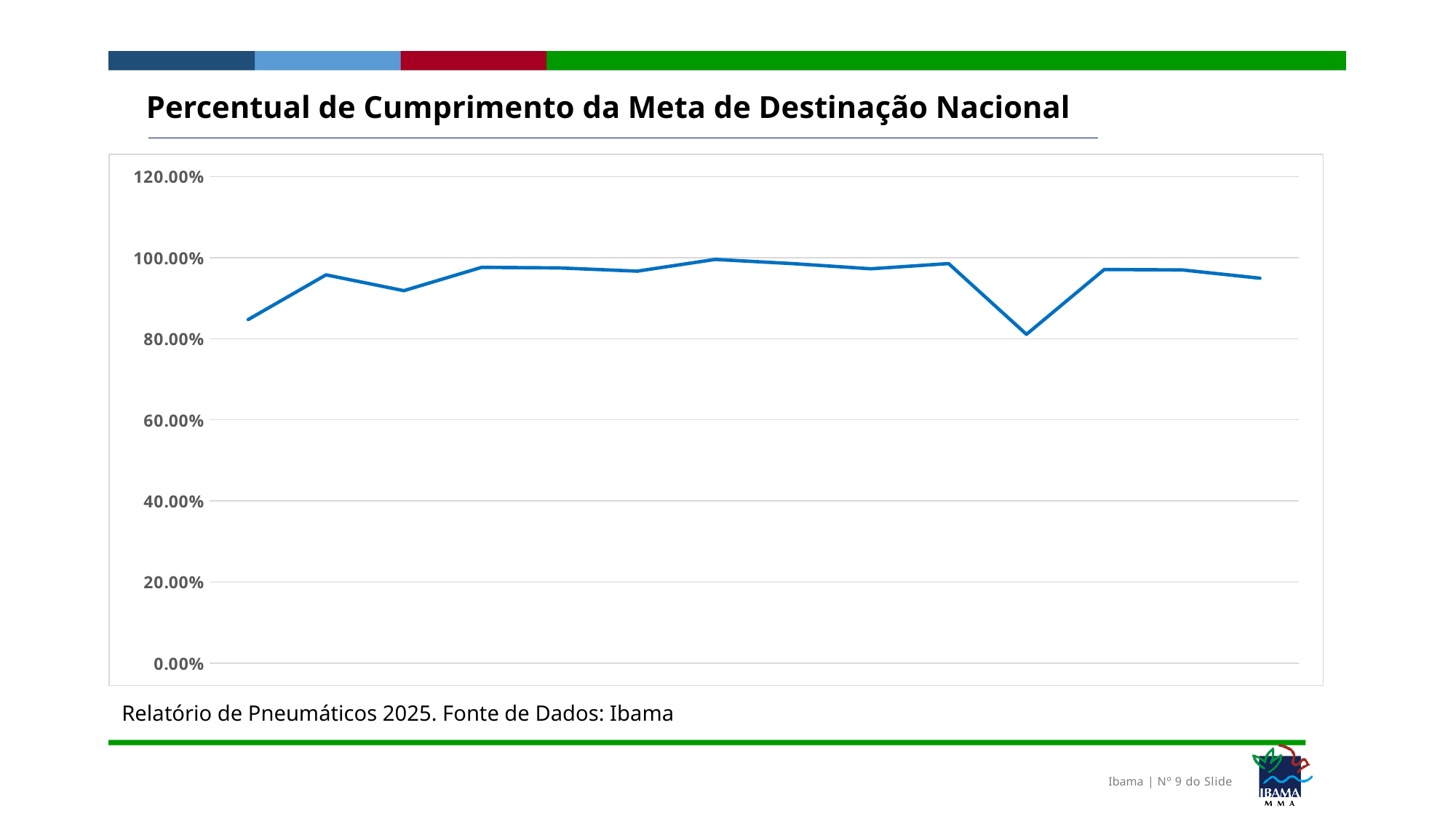
What kind of chart is shown on the slide? line chart Which is larger, the value of the first point or the value of the second point? the second point How many lines (series) are plotted on the chart? 1 Does the line rise or fall between the 10th and 11th points? fall Which point on the line has the lowest value? the 11th point How many data points are plotted on the line? 14 Is the value of the last point on the line greater or less than 80.00%? greater Which is larger, the value of the 11th point or the value of the 12th point? the 12th point Is the value of the first point on the line greater or less than 80.00%? greater What is the title of the chart? Percentual de Cumprimento da Meta de Destinação Nacional What is the highest value shown on the y axis? 120.00% Is the value of the lowest point on the line greater or less than 90.00%? less